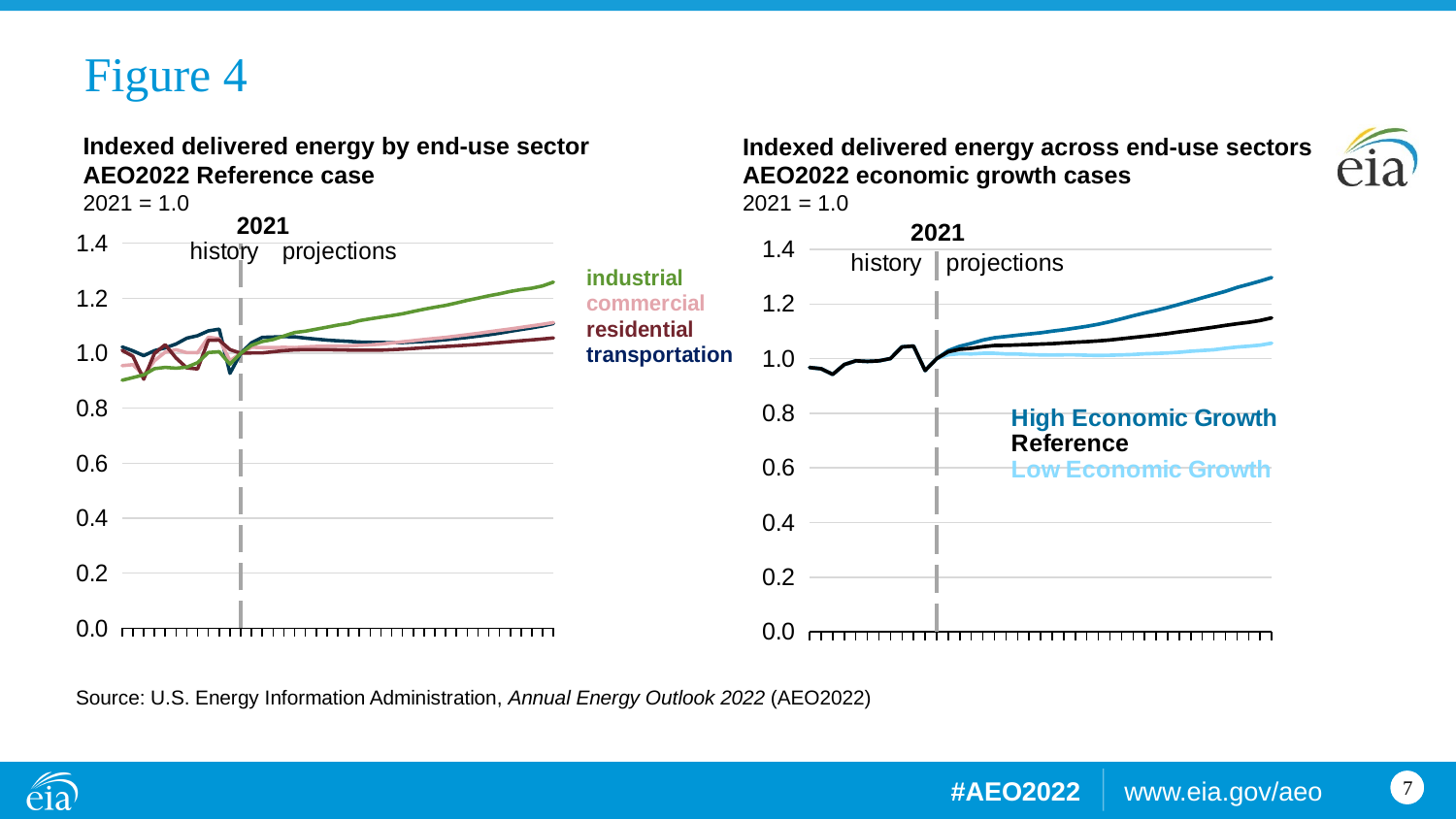
In the right chart, 'Indexed delivered energy across end-use sectors', which case has the highest value at the end of the projection period? High Economic Growth In the left chart, 'Indexed delivered energy by end-use sector', which sector has the highest value at the end of the projection period? industrial What year is used as the index base (= 1.0) in both charts? 2021 What kind of chart is the left chart, 'Indexed delivered energy by end-use sector'? line chart In the right chart, 'Indexed delivered energy across end-use sectors', which case has the lowest value at the end of the projection period? Low Economic Growth In the left chart, 'Indexed delivered energy by end-use sector', is the industrial value at the end of the projection period greater or less than 1.2? greater In the right chart, 'Indexed delivered energy across end-use sectors', which is larger at the end of the projection period: High Economic Growth or Reference? High Economic Growth How many series does the left chart, 'Indexed delivered energy by end-use sector', show? 4 In the left chart, 'Indexed delivered energy by end-use sector', does the industrial line rise or fall over the projection period? rise How many series does the right chart, 'Indexed delivered energy across end-use sectors', show? 3 What kind of chart is the right chart, 'Indexed delivered energy across end-use sectors'? line chart In the right chart, 'Indexed delivered energy across end-use sectors', is the Low Economic Growth value at the end of the projection period greater or less than 1.2? less